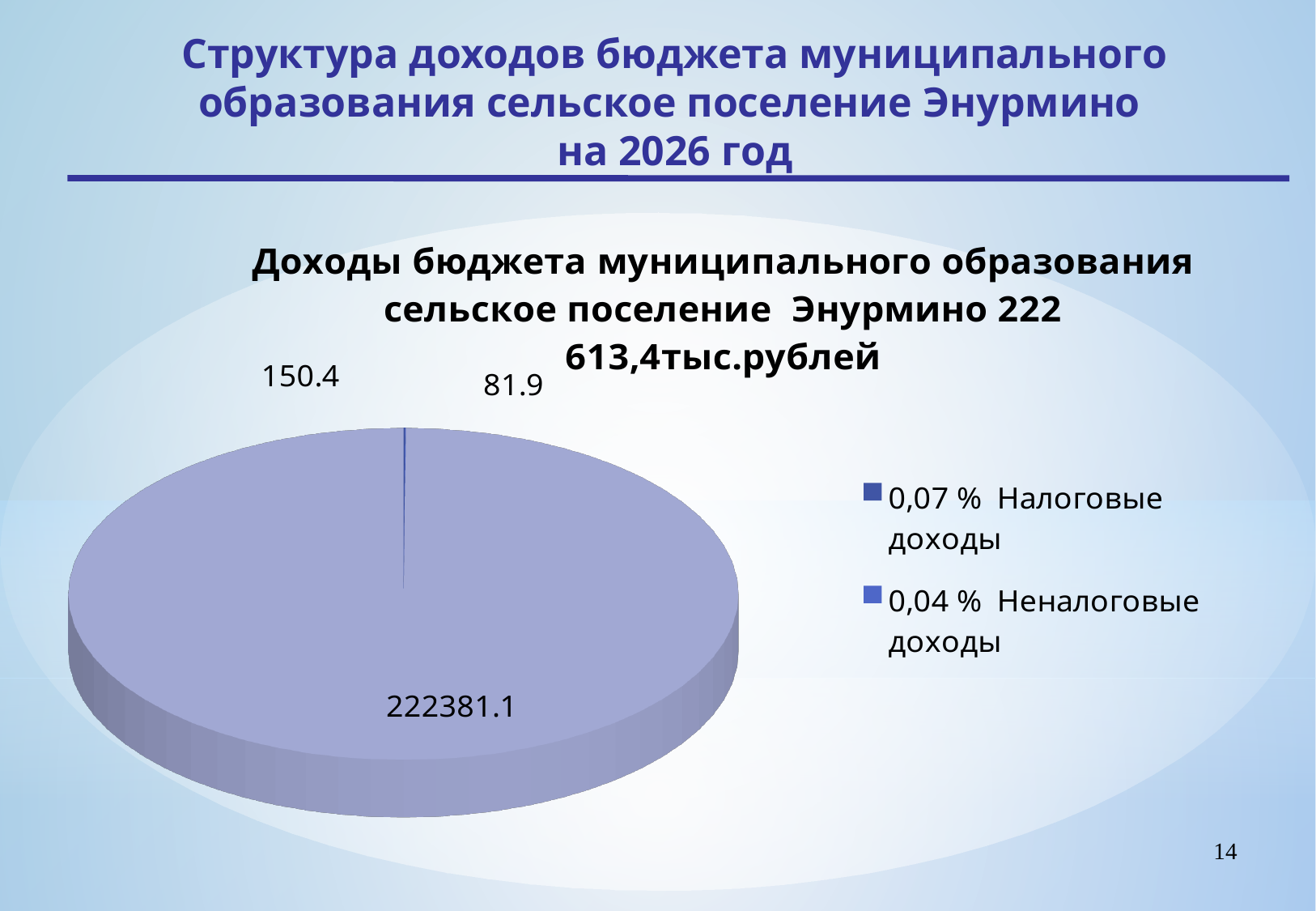
What total revenue amount is stated in the chart title? 222 613,4 тыс.рублей According to the legend, what share of the budget revenue do Неналоговые доходы make up? 0,04 % How many slices (data labels) does the pie chart show? 3 What type of chart is shown on the slide? pie chart What is the largest value labelled on the pie chart? 222381.1 What percentage is shown in the legend next to Налоговые доходы? 0,07 % What is the value shown for Налоговые доходы? 150.4 What is the smallest value labelled on the pie chart? 81.9 How many entries does the legend of the pie chart list? 2 What is the value shown for Неналоговые доходы? 81.9 What is the difference between the values 150.4 and 81.9 on the pie chart? 68.5 Which is larger: the value for Налоговые доходы or the value for Неналоговые доходы? Налоговые доходы